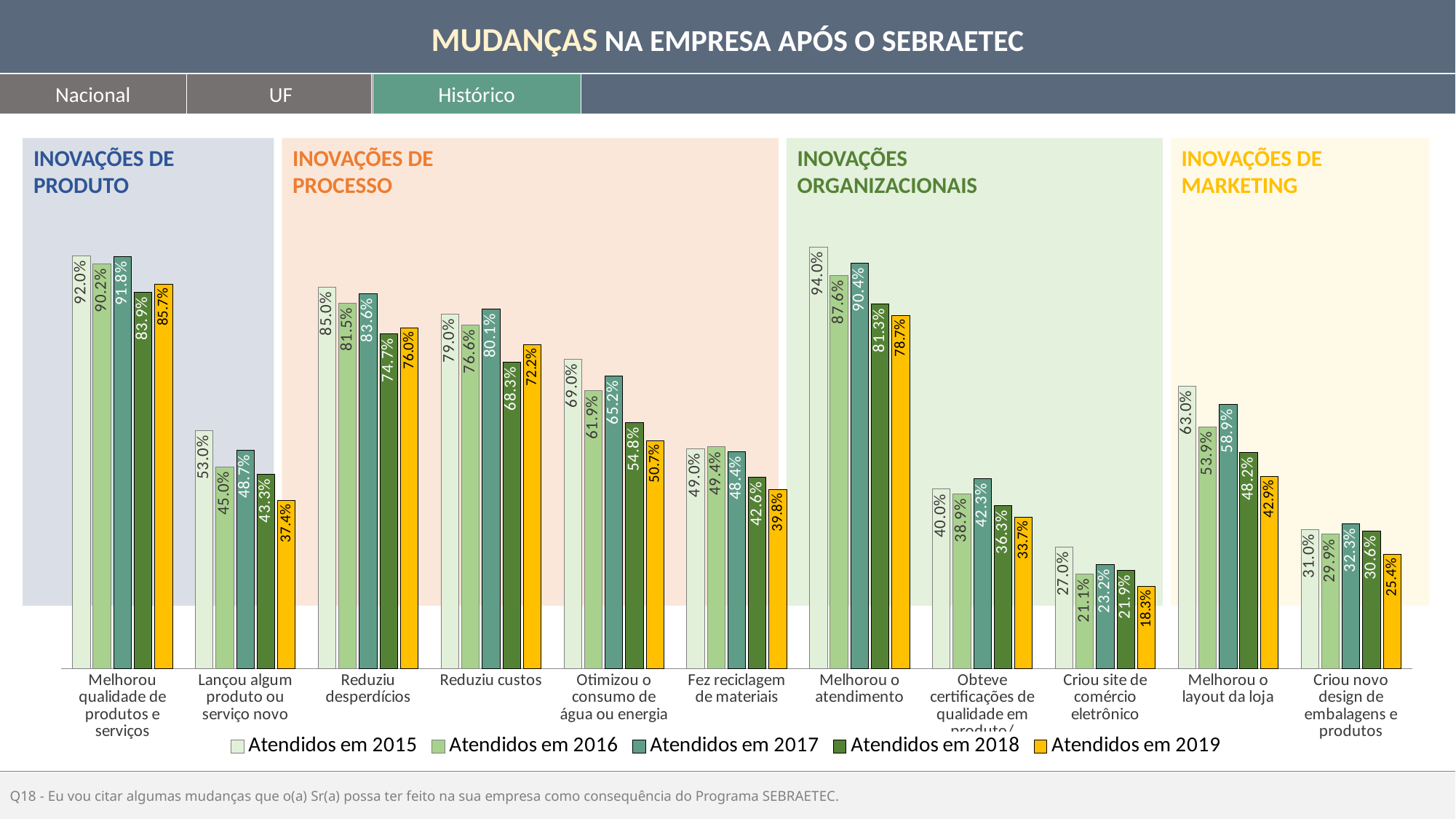
What is the value for 'Reduziu custos' for 'Atendidos em 2017'? 80.1% What type of chart is shown on the slide? bar chart Do the values for 'Lançou algum produto ou serviço novo' generally rise or fall from 'Atendidos em 2015' to 'Atendidos em 2019'? fall How many series does the legend list? 5 Which category has the highest value for 'Atendidos em 2019'? Melhorou qualidade de produtos e serviços How many categories are shown along the x axis? 11 For 'Otimizou o consumo de água ou energia', which is larger: the value for 'Atendidos em 2016' or 'Atendidos em 2017'? Atendidos em 2017 Which series is shown in yellow/orange in the legend? Atendidos em 2019 Which category has the lowest value for 'Atendidos em 2015'? Criou site de comércio eletrônico What is the value for 'Criou site de comércio eletrônico' for 'Atendidos em 2019'? 18.3% What is the value for 'Melhorou o atendimento' for 'Atendidos em 2015'? 94.0% What is the difference between the 'Atendidos em 2015' and 'Atendidos em 2019' values for 'Melhorou o layout da loja'? 20.1%